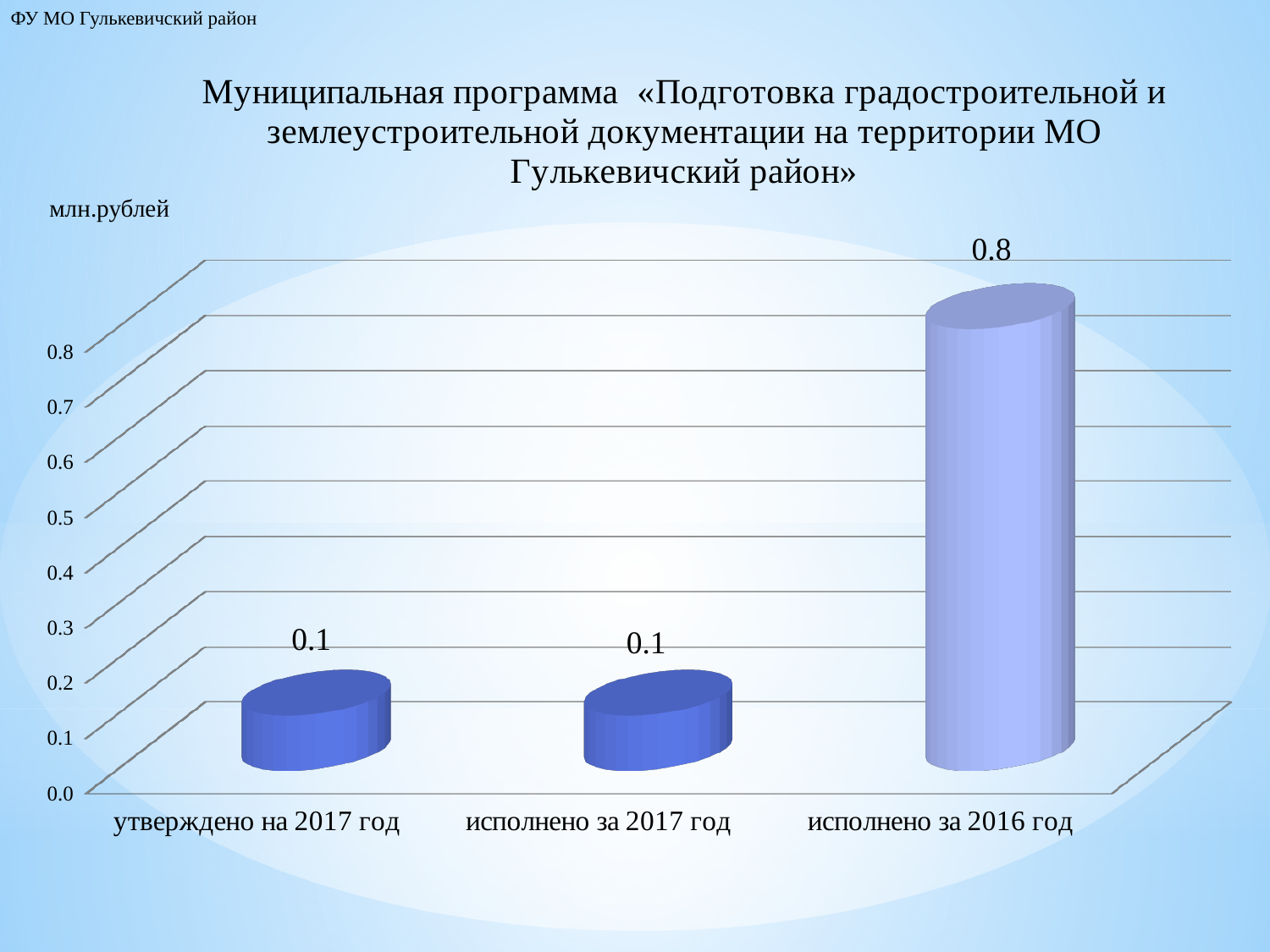
Which category has the highest value? исполнено за 2016 год Is the value for "исполнено за 2016 год" greater or less than 0.5? greater What is the highest value shown on the vertical axis? 0.8 What is the value for "исполнено за 2017 год"? 0.1 Is the value for "утверждено на 2017 год" greater or less than 0.4? less Which is larger: the value for "исполнено за 2016 год" or the value for "утверждено на 2017 год"? исполнено за 2016 год What kind of chart is shown on the slide? bar chart How many categories are shown on the chart? 3 What is the value for "исполнено за 2016 год"? 0.8 What is the difference between the values for "исполнено за 2016 год" and "исполнено за 2017 год"? 0.7 What unit is indicated for the values on the chart? млн.рублей What is the value for "утверждено на 2017 год"? 0.1